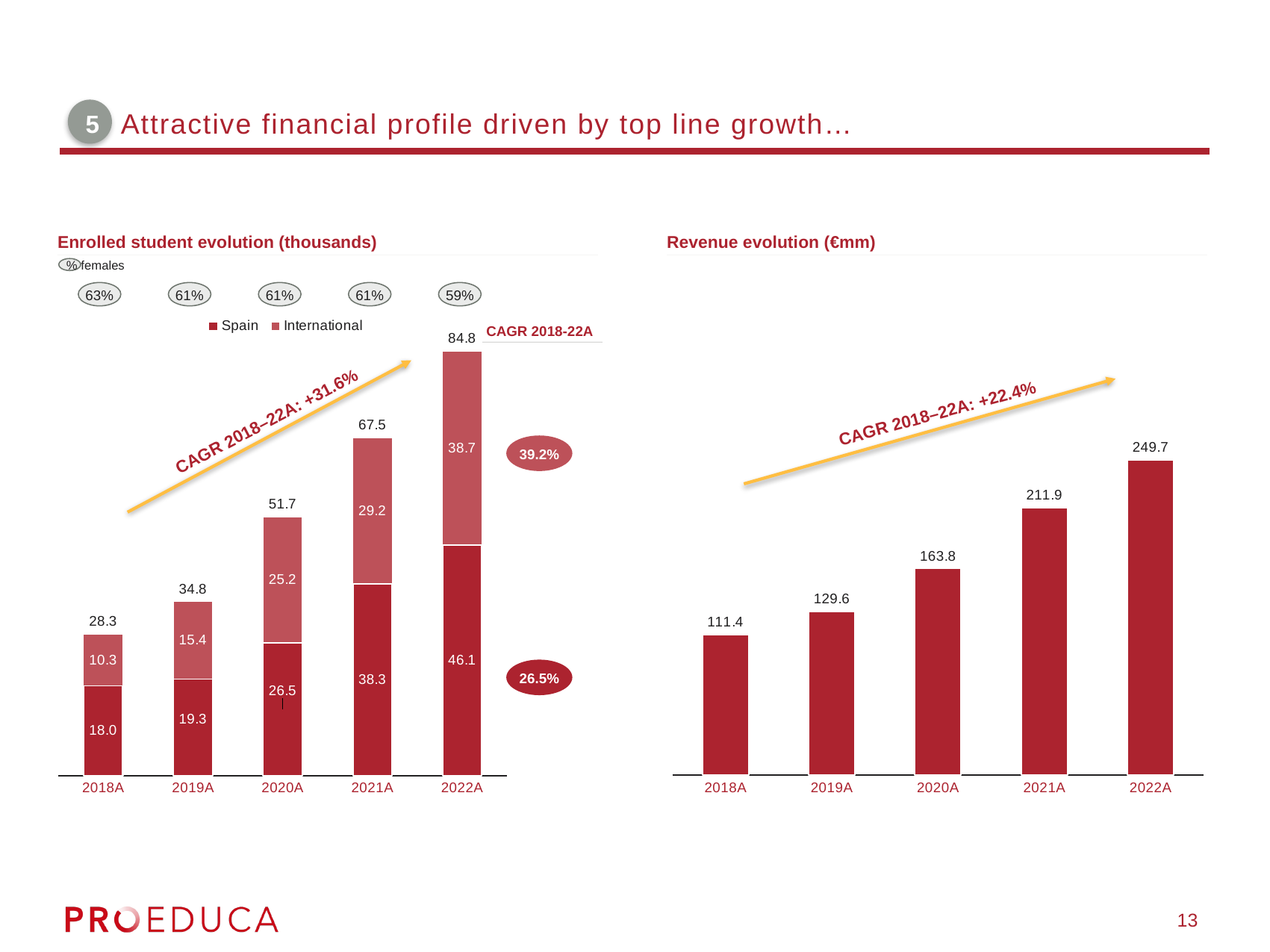
In the 'Enrolled student evolution (thousands)' chart, which year has the lowest total enrolled students? 2018A In the 'Enrolled student evolution (thousands)' chart, how many series does the legend list? 2 In the 'Revenue evolution (€mm)' chart, which year has the highest revenue? 2022A In the 'Revenue evolution (€mm)' chart, what is the revenue for 2020A? 163.8 In the 'Enrolled student evolution (thousands)' chart, what is the International value for 2020A? 25.2 In the 'Enrolled student evolution (thousands)' chart, what is the Spain value for 2021A? 38.3 In the 'Revenue evolution (€mm)' chart, how many years are plotted? 5 In the 'Revenue evolution (€mm)' chart, what is the difference in revenue between 2022A and 2018A? 138.3 In the 'Enrolled student evolution (thousands)' chart, what is the difference between the International values for 2022A and 2021A? 9.5 In the 'Enrolled student evolution (thousands)' chart, what is the CAGR 2018-22A shown for the International series? 39.2% In the 'Revenue evolution (€mm)' chart, do revenues rise or fall from 2018A to 2022A? rise In the 'Enrolled student evolution (thousands)' chart, what is the total enrolled students for 2022A? 84.8